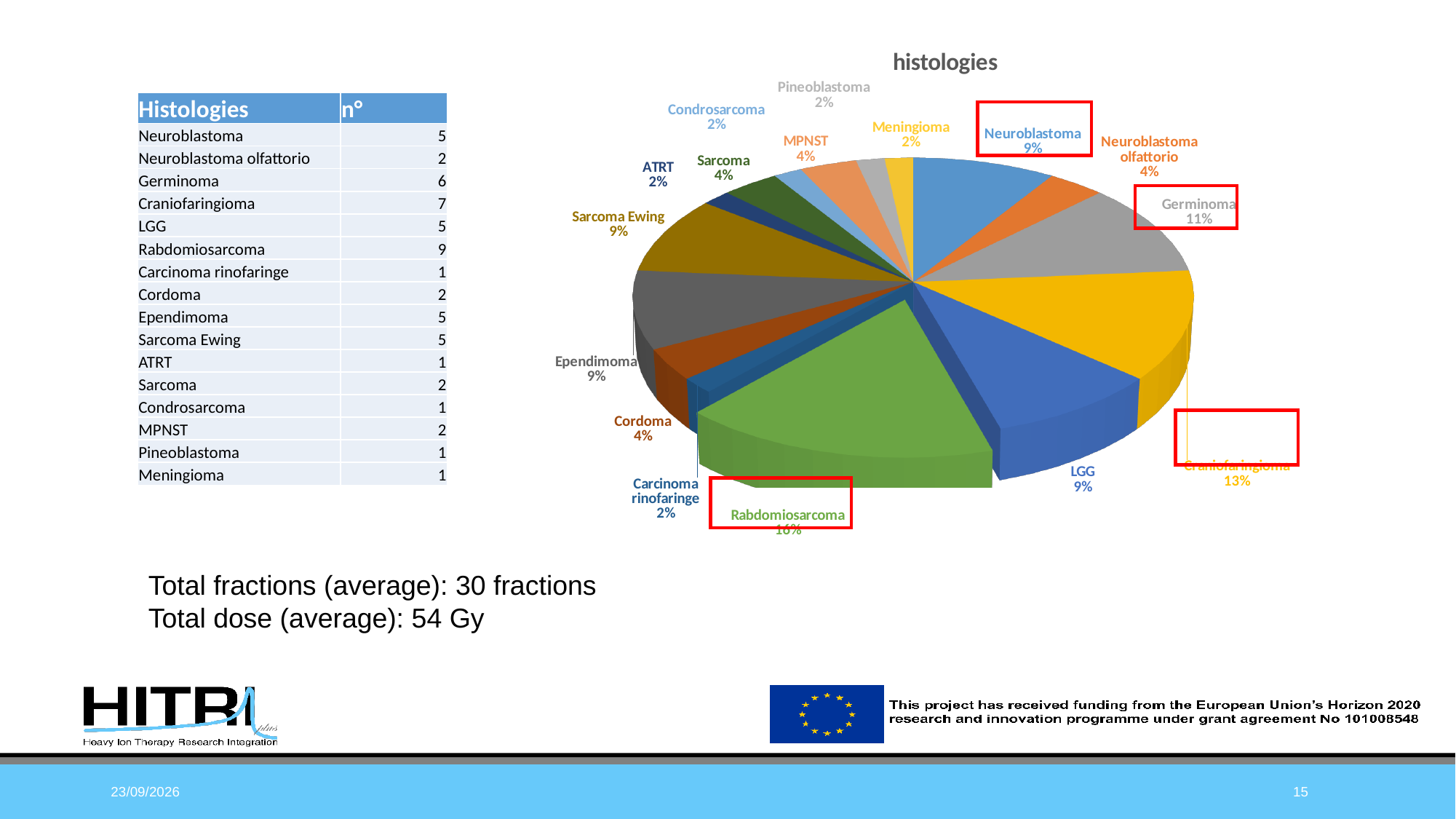
What share of the pie does Germinoma represent? 11% Which histology has the largest slice in the pie chart? Rabdomiosarcoma What percentage is shown for Craniofaringioma in the pie chart? 13% What is the title of the chart? histologies What percentage is shown for Sarcoma Ewing in the pie chart? 9% What percentage is shown for MPNST in the pie chart? 4% What percentage is shown for Pineoblastoma in the pie chart? 2% Which has a larger share, Cordoma or Ependimoma? Ependimoma How many slices does the pie chart have? 16 Which has a larger share, Germinoma or LGG? Germinoma What is the difference in percentage points between Craniofaringioma and Germinoma? 2% What kind of chart is shown on the slide? pie chart